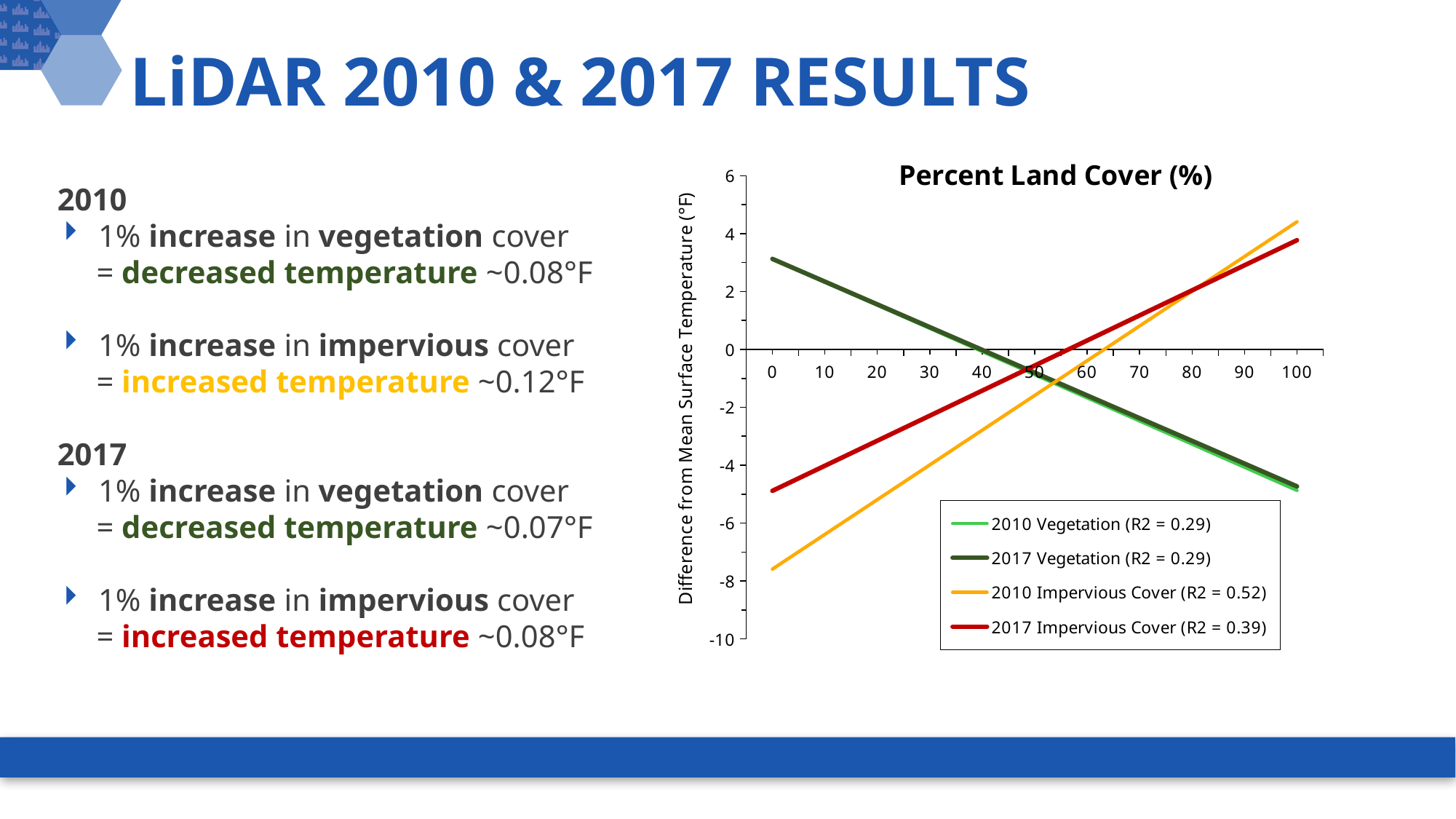
At 0% land cover, which line is lower: 2010 Impervious Cover or 2017 Impervious Cover? 2010 Impervious Cover Is the value of the 2010 Impervious Cover line at 100% land cover greater or less than 2? greater Is the value of the 2017 Vegetation line at 0% land cover greater or less than 2? greater Does the 2010 Impervious Cover line rise or fall as percent land cover increases? rises Is the value of the 2017 Impervious Cover line at 0% land cover greater or less than -4? less How many series does the chart legend list? 4 Does the 2017 Vegetation line rise or fall as percent land cover increases? falls What kind of chart is shown on the slide? line chart What is the title of the chart? Percent Land Cover (%) What R2 value does the legend give for 2010 Impervious Cover? 0.52 At 100% land cover, which line is higher: 2010 Impervious Cover or 2017 Impervious Cover? 2010 Impervious Cover